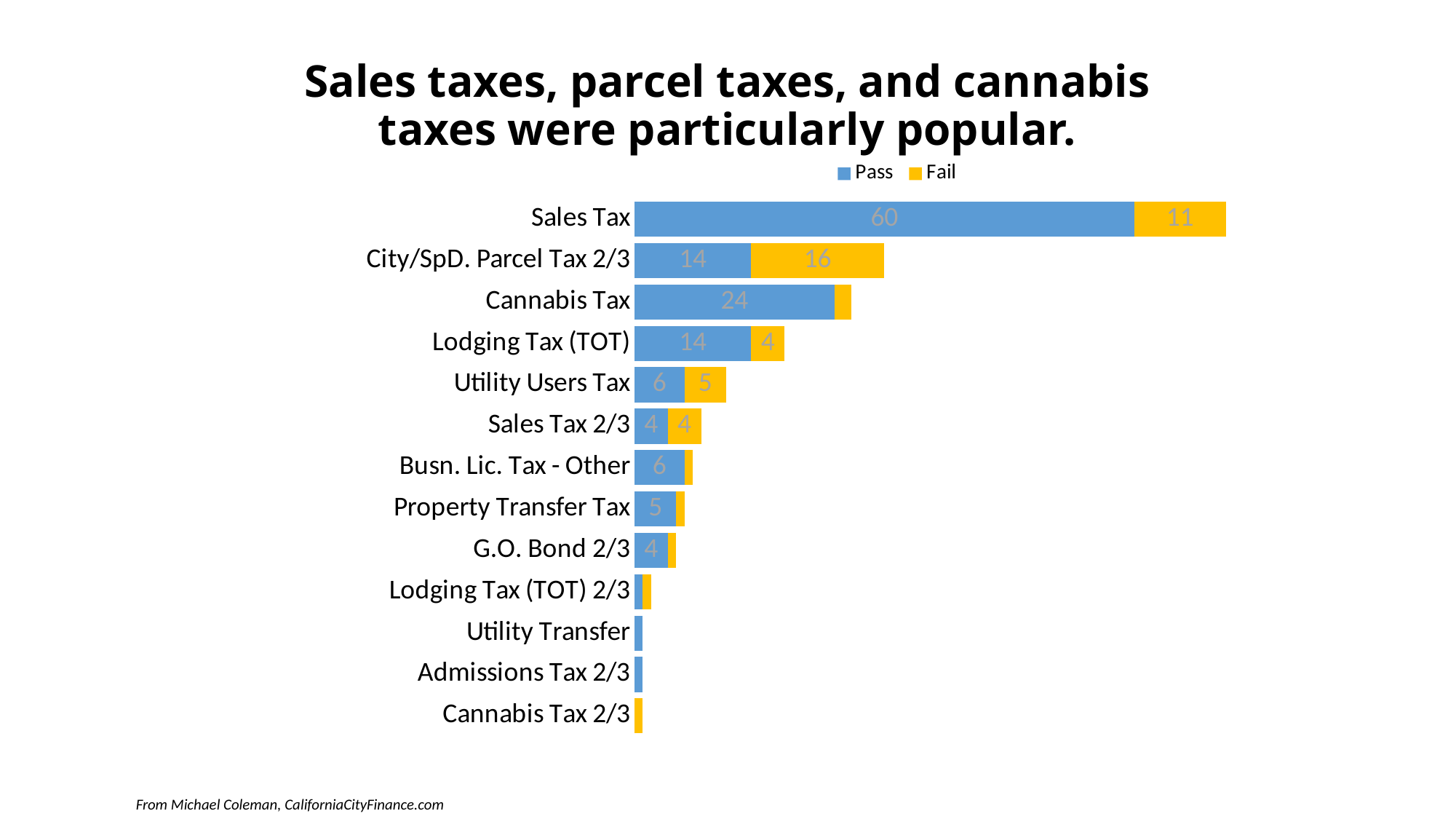
Which category has the highest Fail value? City/SpD. Parcel Tax 2/3 Which category has the highest Pass value? Sales Tax Which is larger for City/SpD. Parcel Tax 2/3, the Pass value or the Fail value? Fail How many categories are shown on the chart? 13 What is the Fail value for City/SpD. Parcel Tax 2/3? 16 How many Sales Tax measures failed? 11 How many Sales Tax measures passed? 60 What is the Pass value for Cannabis Tax? 24 What is the total of the Pass and Fail values for Lodging Tax (TOT)? 18 What kind of chart is shown on the slide? Stacked bar chart How many series does the legend list? 2 What is the difference between the Pass and Fail values for Sales Tax? 49